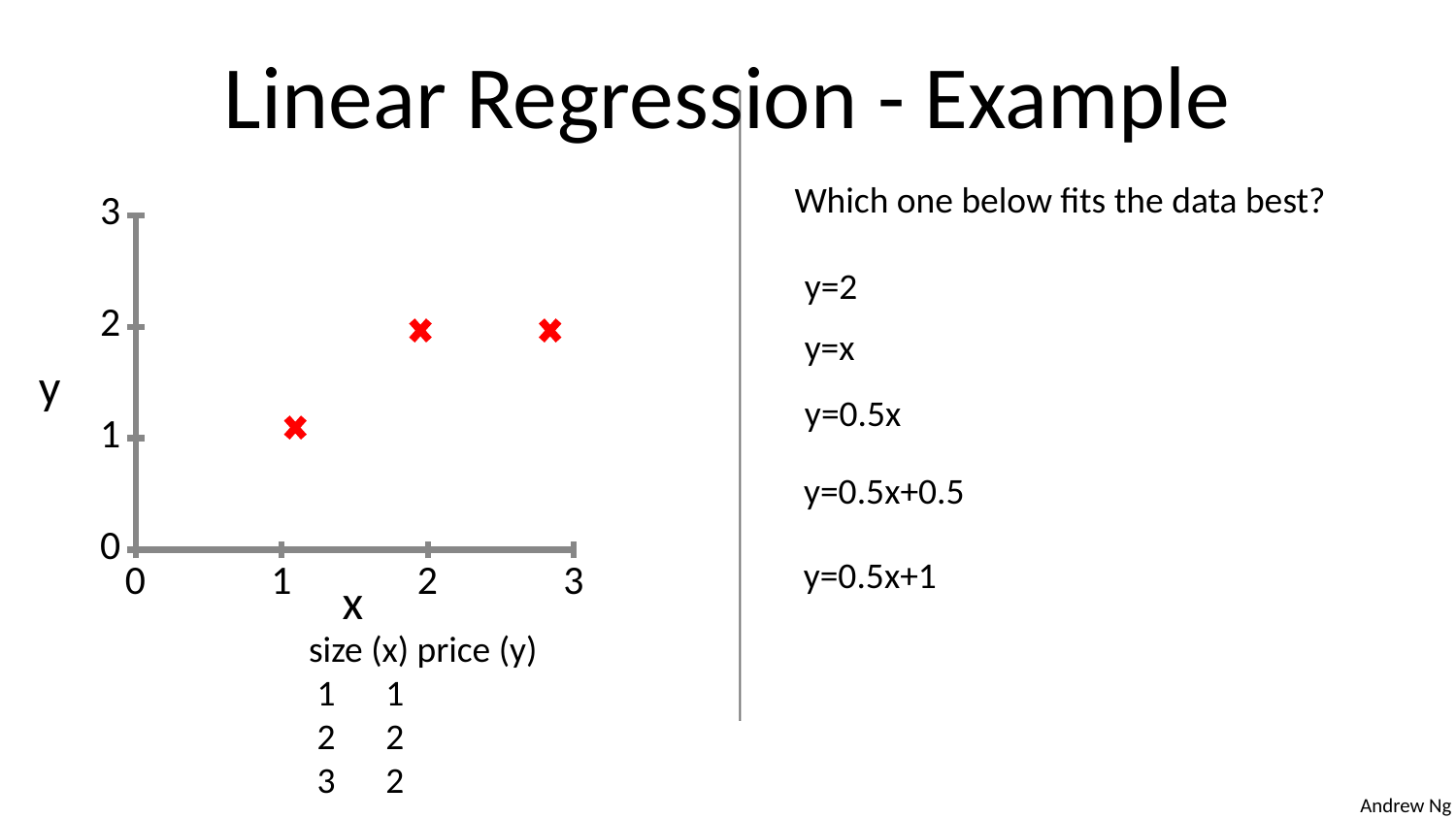
What is the price (y) value when size (x) is 2? 2 What is the label on the vertical axis of the chart? y What kind of chart is shown on the slide? scatter plot What is the maximum value shown on the x axis of the chart? 3 What is the difference in price (y) between size (x) = 2 and size (x) = 1? 1 Which is larger, the price (y) at size (x) = 2 or at size (x) = 1? size (x) = 2 Is the price (y) at size (x) = 1 greater or less than 2? less Which size (x) value has the lowest price (y)? 1 What is the price (y) value when size (x) is 3? 2 How many data points are plotted on the chart? 3 Do the price (y) values rise or fall as size (x) increases from 1 to 2? rise What is the price (y) value when size (x) is 1? 1